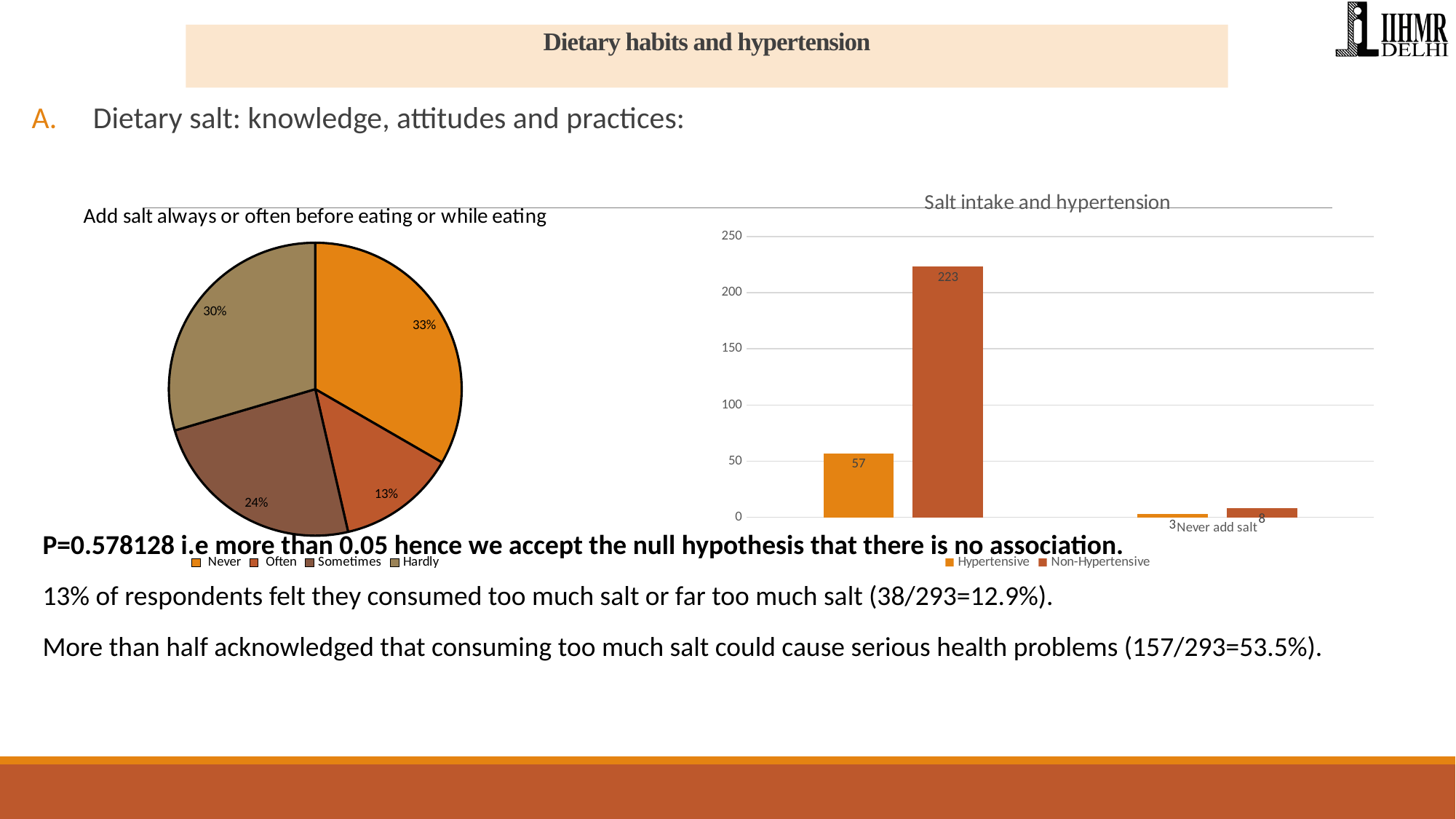
How many categories does the legend of the pie chart 'Add salt always or often before eating or while eating' list? 4 In the 'Salt intake and hypertension' chart, what is the Non-Hypertensive value for 'Never add salt'? 8 In the 'Salt intake and hypertension' chart, what is the Hypertensive value for 'Never add salt'? 3 In the pie chart 'Add salt always or often before eating or while eating', what share does the 'Hardly' slice have? 30% In the pie chart 'Add salt always or often before eating or while eating', what is the difference between the 'Sometimes' and 'Often' shares? 11% In the pie chart 'Add salt always or often before eating or while eating', which category has the smallest slice? Often How many series does the legend of the 'Salt intake and hypertension' chart list? 2 In the 'Salt intake and hypertension' chart, what is the highest value shown on any bar? 223 In the pie chart 'Add salt always or often before eating or while eating', which category has the largest slice? Never What kind of chart is 'Salt intake and hypertension'? Bar chart In the pie chart 'Add salt always or often before eating or while eating', what share does the 'Often' slice have? 13% In the pie chart 'Add salt always or often before eating or while eating', what share does the 'Never' slice have? 33%